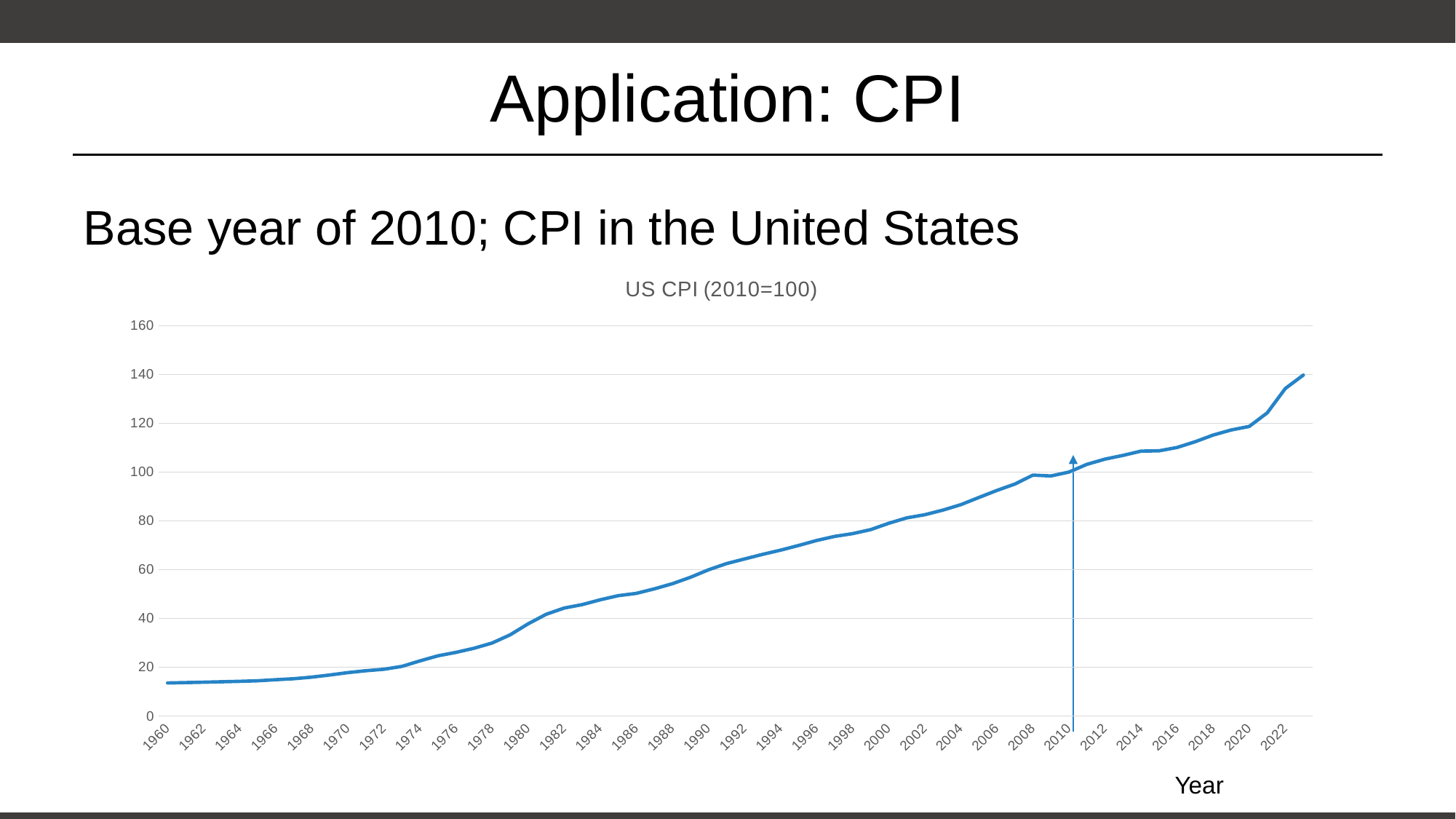
What is the title of the chart? US CPI (2010=100) Do the CPI values generally rise or fall from 1960 to 2022? rise Is the value for 2016 greater or less than 100? greater Which year has the lowest CPI value on the chart? 1960 What is the CPI value for the base year 2010? 100 What is the label of the x axis? Year What type of chart is shown on the slide? line chart Is the value for 1976 greater or less than 20? greater Is the value for 2022 greater or less than 120? greater Which is larger, the CPI value for 1990 or for 2010? 2010